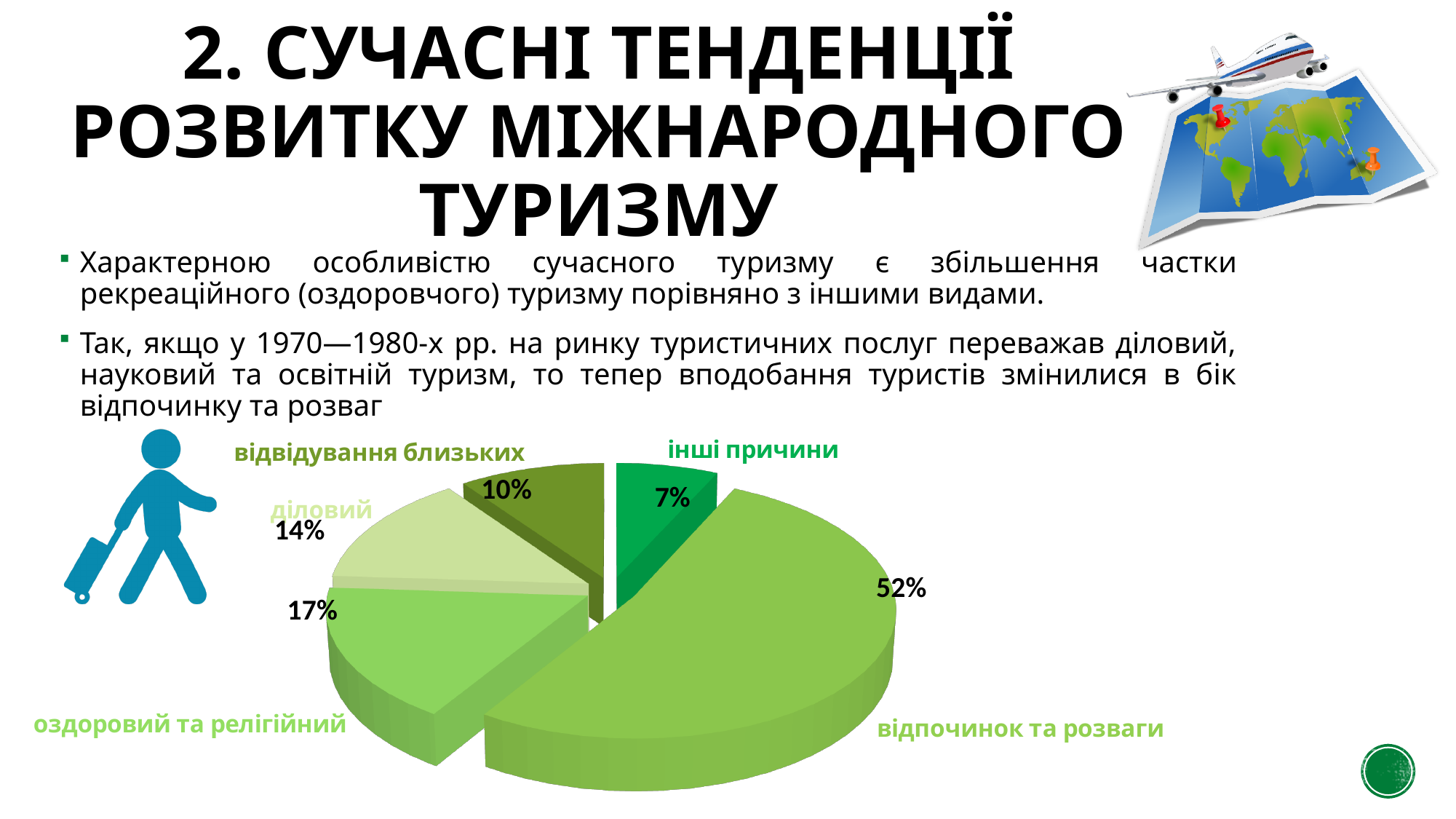
Is the share for "відпочинок та розваги" greater or less than 50%? greater What is the difference between the shares of "відпочинок та розваги" and "оздоровий та релігійний"? 35% What share of the pie does "відпочинок та розваги" have? 52% What share of the pie does "інші причини" have? 7% Which category has the smallest slice of the pie? інші причини Which category has the largest slice of the pie? відпочинок та розваги How many slices does the pie chart have? 5 Which is larger: the share for "діловий" or the share for "відвідування близьких"? діловий What share of the pie does "оздоровий та релігійний" have? 17% What share of the pie does "відвідування близьких" have? 10% What kind of chart is shown on the slide? pie chart What share of the pie does "діловий" have? 14%